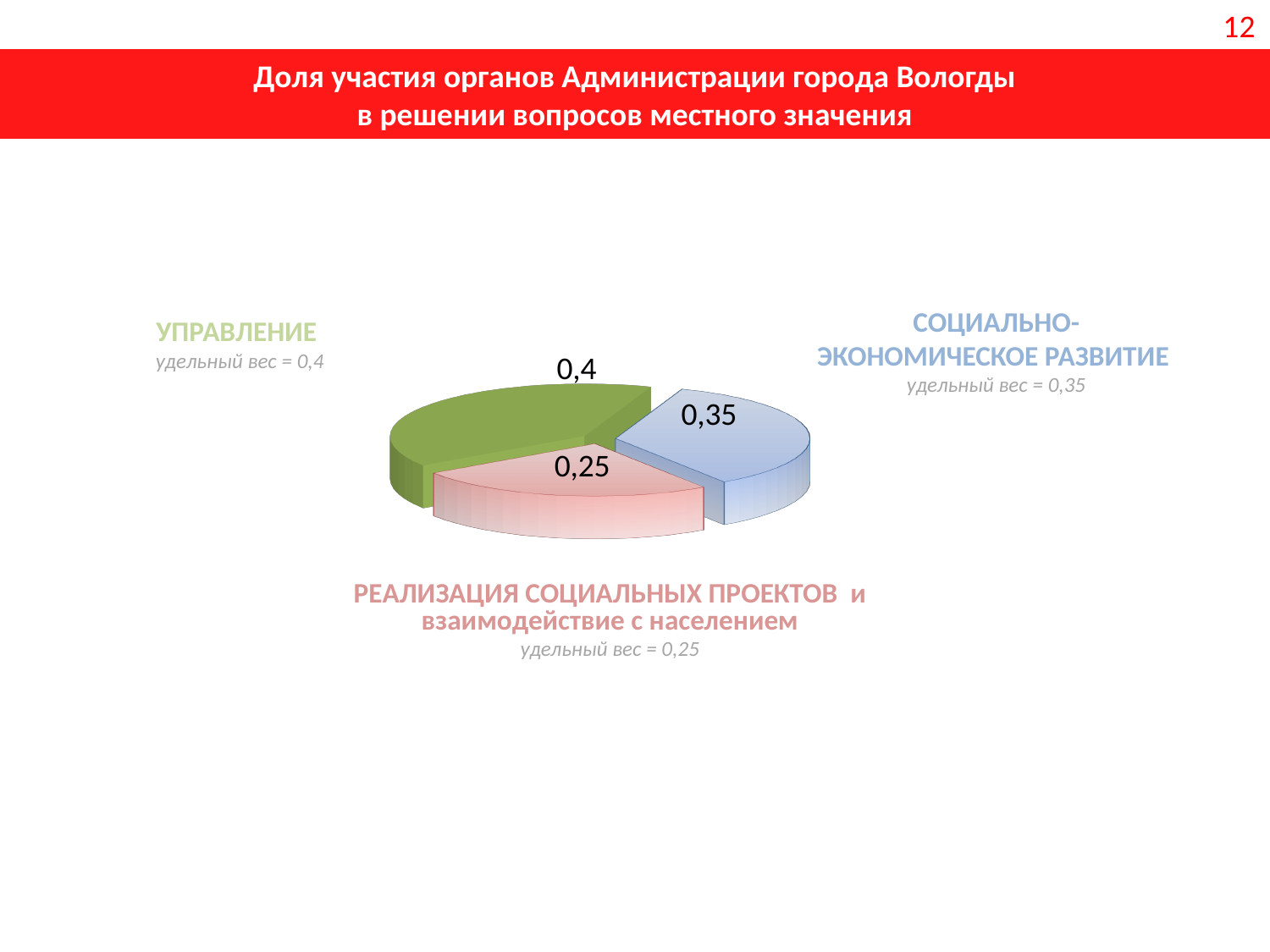
What is the total of the three values shown on the pie chart? 1 What is the value shown for the СОЦИАЛЬНО-ЭКОНОМИЧЕСКОЕ РАЗВИТИЕ slice? 0,35 What is the difference between the values for УПРАВЛЕНИЕ and СОЦИАЛЬНО-ЭКОНОМИЧЕСКОЕ РАЗВИТИЕ? 0,05 Which category has the smallest share of the pie chart? РЕАЛИЗАЦИЯ СОЦИАЛЬНЫХ ПРОЕКТОВ и взаимодействие с населением Which category has the largest share of the pie chart? УПРАВЛЕНИЕ What kind of chart is shown on the slide? Pie chart What is the value shown for the РЕАЛИЗАЦИЯ СОЦИАЛЬНЫХ ПРОЕКТОВ и взаимодействие с населением slice? 0,25 How many slices does the pie chart have? 3 Which is larger: the value for СОЦИАЛЬНО-ЭКОНОМИЧЕСКОЕ РАЗВИТИЕ or the value for РЕАЛИЗАЦИЯ СОЦИАЛЬНЫХ ПРОЕКТОВ и взаимодействие с населением? СОЦИАЛЬНО-ЭКОНОМИЧЕСКОЕ РАЗВИТИЕ What is the title of the slide containing the pie chart? Доля участия органов Администрации города Вологды в решении вопросов местного значения What colour is the УПРАВЛЕНИЕ slice of the pie chart? Green What is the value shown for the УПРАВЛЕНИЕ slice of the pie chart? 0,4